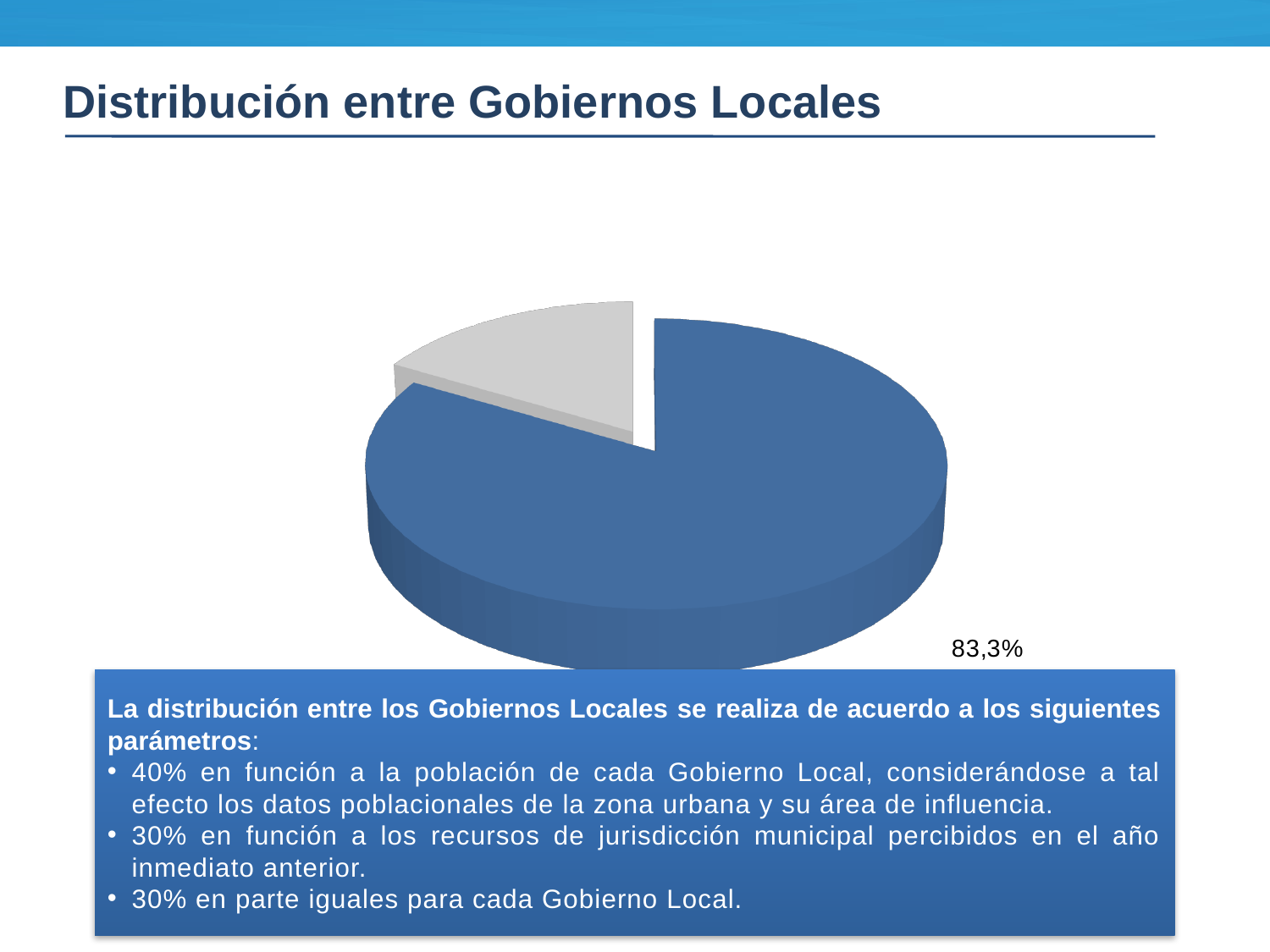
What percentage is printed on the large blue slice of the pie chart? 83,3% How many slices does the pie chart have? 2 Is the blue slice of the pie chart larger or smaller than the grey slice? larger What is the title of the slide containing the pie chart? Distribución entre Gobiernos Locales Which slice of the pie chart is the smallest, the blue one or the grey one? the grey one What colour is the slice of the pie chart labelled 83,3%? blue What kind of chart is shown on the slide? pie chart Which slice of the pie chart is the largest, the blue one or the grey one? the blue one